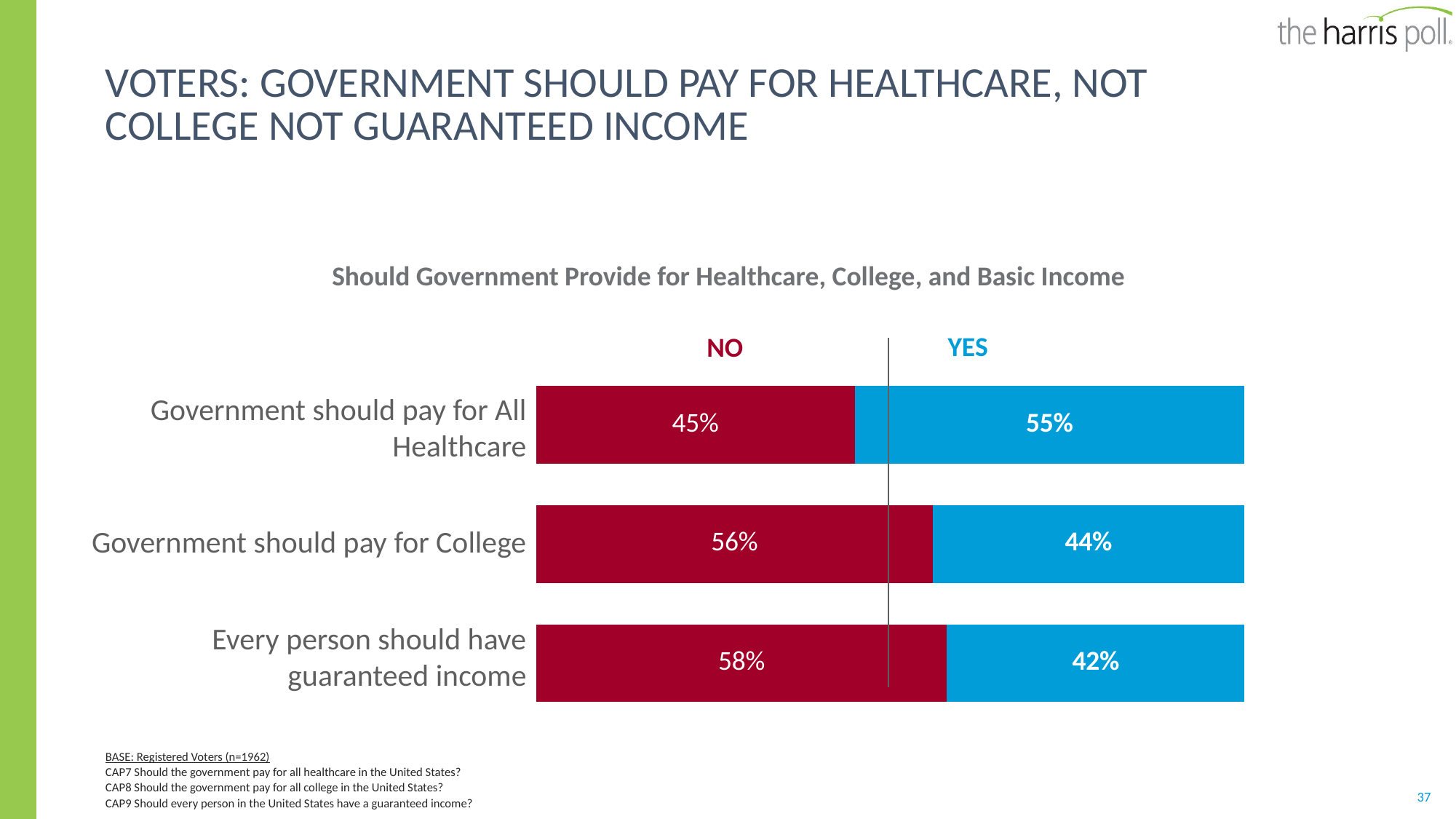
Which statement has the highest NO percentage? Every person should have guaranteed income Is the YES percentage larger for 'Government should pay for All Healthcare' or for 'Government should pay for College'? Government should pay for All Healthcare What percentage of voters said NO to 'Government should pay for College'? 56% What percentage of voters said YES to 'Government should pay for All Healthcare'? 55% How many statements are shown in the chart? 3 What is the total of the NO and YES percentages for 'Every person should have guaranteed income'? 100% What is the title of the chart? Should Government Provide for Healthcare, College, and Basic Income What type of chart is shown on the slide? Stacked horizontal bar chart What percentage of voters said YES to 'Every person should have guaranteed income'? 42% What is the difference between the NO and YES percentages for 'Government should pay for College'? 12 percentage points Which statement has the lowest YES percentage? Every person should have guaranteed income How many response categories (series) does the chart show? 2